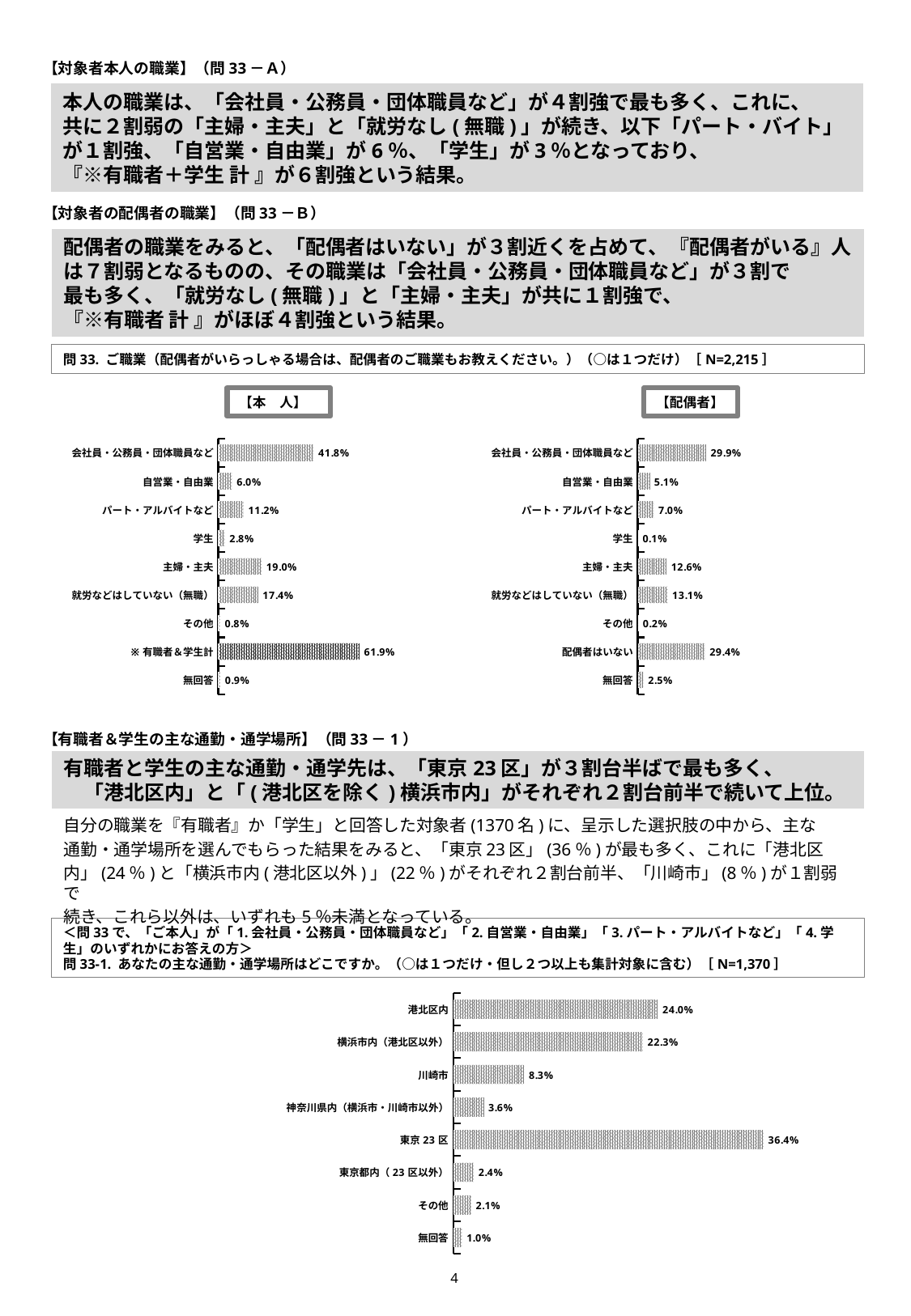
In the 【配偶者】 chart, what is the value for 学生? 0.1% In the 【本 人】 chart, what is the difference between 主婦・主夫 and 就労などはしていない（無職）? 1.6% In the 問33-1 commuting/school location chart, which category has the highest value? 東京23区 How many categories are shown in the 問33-1 commuting/school location chart? 8 In the 【本 人】 chart, what is the value for 主婦・主夫? 19.0% What type of chart is the 【配偶者】 chart? Bar chart In the 【配偶者】 chart, what is the value for 配偶者はいない? 29.4% In the 【配偶者】 chart, which is larger: 会社員・公務員・団体職員など or 配偶者はいない? 会社員・公務員・団体職員など In the 問33-1 commuting/school location chart, what is the value for 川崎市? 8.3% In the 問33-1 commuting/school location chart, what is the difference between 港北区内 and 横浜市内（港北区以外）? 1.7% In the 【本 人】 chart, which category has the lowest value? その他 In the 【本 人】 chart, what is the value for 会社員・公務員・団体職員など? 41.8%